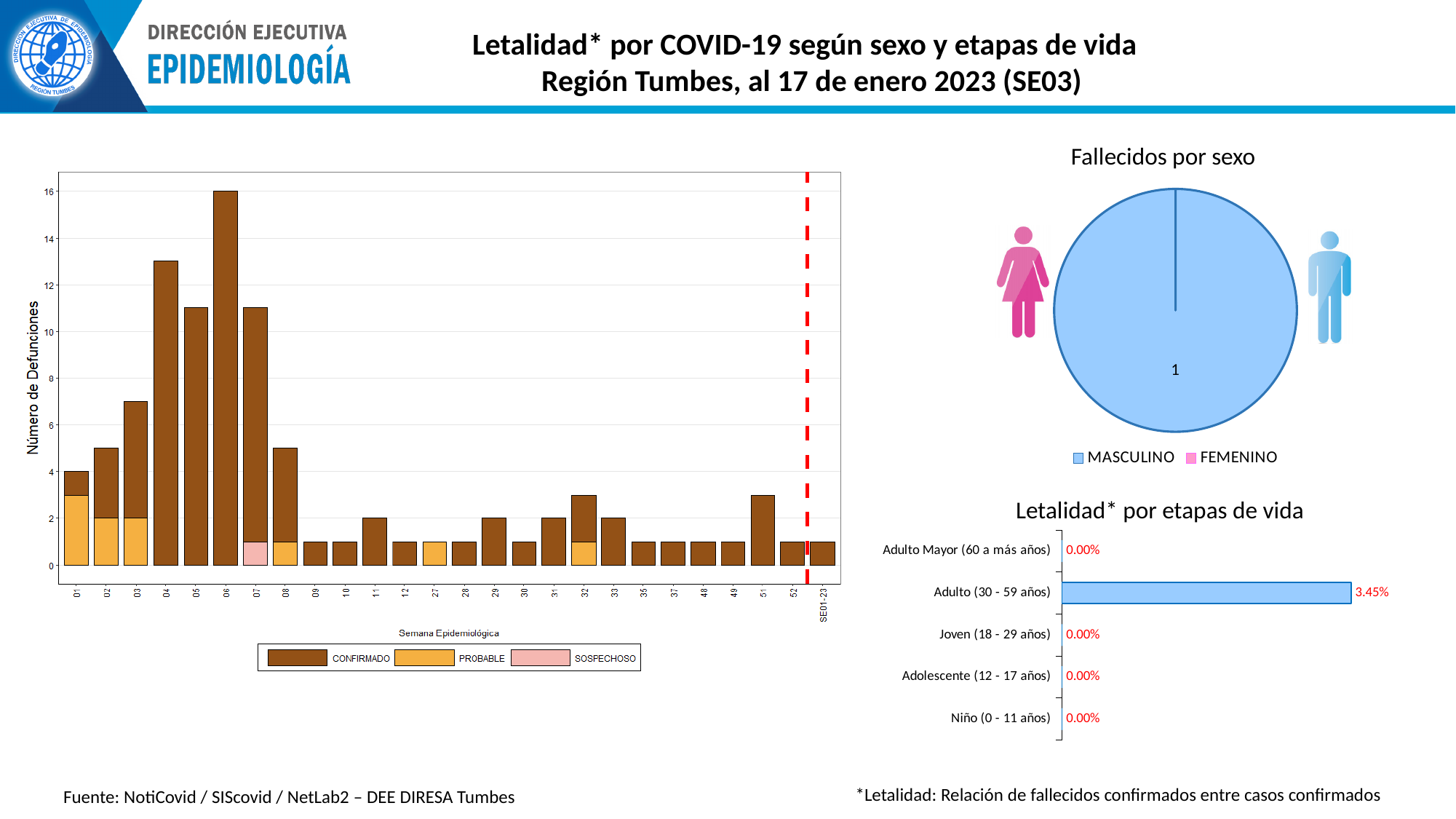
In the chart 'Letalidad* por etapas de vida', what is the value for Niño (0 - 11 años)? 0.00% In the pie chart 'Fallecidos por sexo', what value is printed on the MASCULINO slice? 1 In the chart 'Letalidad* por etapas de vida', how many age groups are shown? 5 In the chart 'Letalidad* por etapas de vida', what is the difference between the value for Adulto (30 - 59 años) and the value for Joven (18 - 29 años)? 3.45% In the pie chart 'Fallecidos por sexo', how many categories does the legend list? 2 In the bar chart on the left (Número de Defunciones by Semana Epidemiológica), which week has the highest number of deaths? 06 In the bar chart on the left (Número de Defunciones by Semana Epidemiológica), what is the total number of deaths in week 06? 16 In the chart 'Letalidad* por etapas de vida', what is the value for Adulto (30 - 59 años)? 3.45% In the bar chart on the left (Número de Defunciones by Semana Epidemiológica), which is larger, the value for week 04 or the value for week 05? week 04 In the bar chart on the left (Número de Defunciones by Semana Epidemiológica), how many series does the legend list? 3 In the chart 'Letalidad* por etapas de vida', which age group has the highest letalidad? Adulto (30 - 59 años) In the bar chart on the left (Número de Defunciones by Semana Epidemiológica), is the value for week 04 greater or less than 12? greater